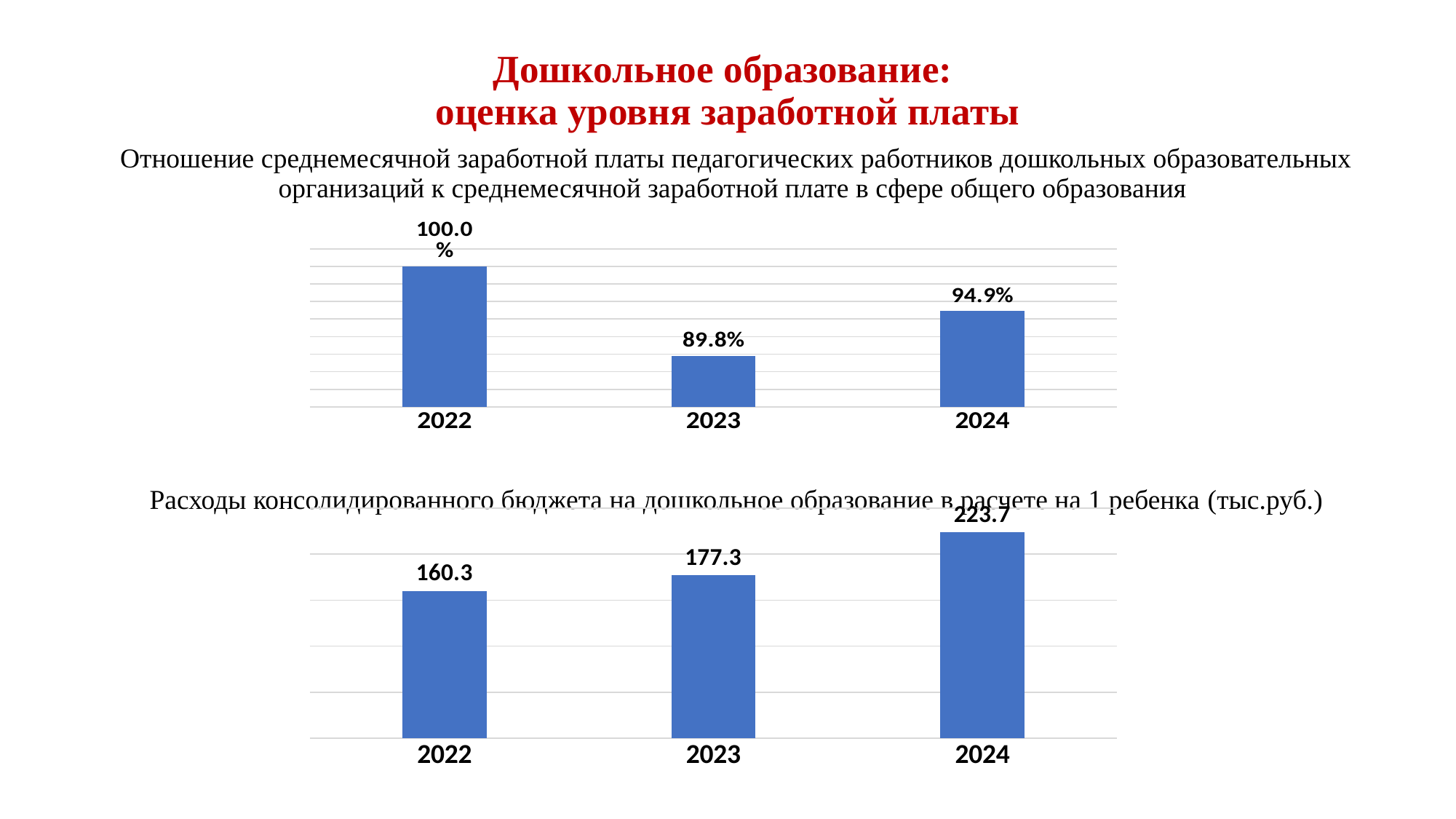
In the bottom chart (budget expenditure per child), what is the value for 2024? 223.7 How many years are shown in the bottom chart (budget expenditure per child)? 3 In the top chart (salary ratio), what is the value for 2024? 94.9% In the top chart (ratio of average monthly salary of preschool teachers to general education), what is the value for 2022? 100.0% In the top chart (salary ratio), which year has the lowest value? 2023 In the bottom chart (budget expenditure per child), do the values rise or fall from 2022 to 2024? rise What type of chart is the top chart (salary ratio)? bar chart In the top chart (salary ratio), which year has the highest value? 2022 In the top chart (salary ratio), what is the value for 2023? 89.8% In the bottom chart (budget expenditure per child), what is the difference between the 2024 and 2023 values? 46.4 In the top chart (salary ratio), what is the difference between the 2022 and 2023 values? 10.2% In the bottom chart (consolidated budget expenditure on preschool education per child, thousand rubles), what is the value for 2022? 160.3